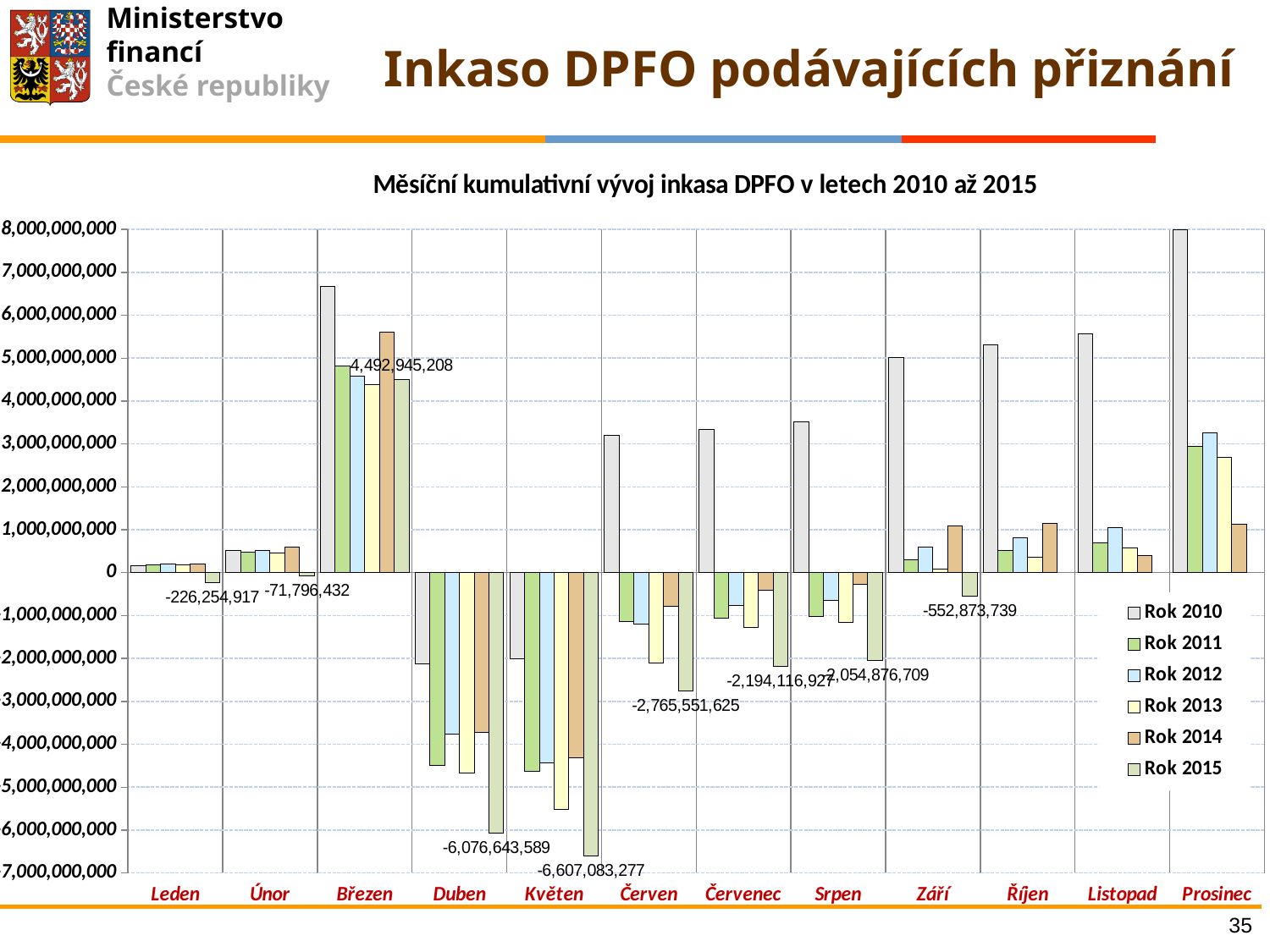
What is the difference between the Rok 2015 values for Duben and Květen? 530,439,688 What kind of chart is shown on the slide? bar chart How many series does the legend list? 6 What is the value for Rok 2015 in Duben? -6,076,643,589 What is the value for Rok 2015 in Září? -552,873,739 What is the value for Rok 2015 in Březen? 4,492,945,208 What is the title of the chart? Měsíční kumulativní vývoj inkasa DPFO v letech 2010 až 2015 How many months are shown on the x axis? 12 Is the value for Rok 2010 in Prosinec greater or less than 7,000,000,000? greater What is the value for Rok 2015 in Leden? -226,254,917 In which month is the Rok 2010 value highest? Prosinec What is the value for Rok 2015 in Květen? -6,607,083,277